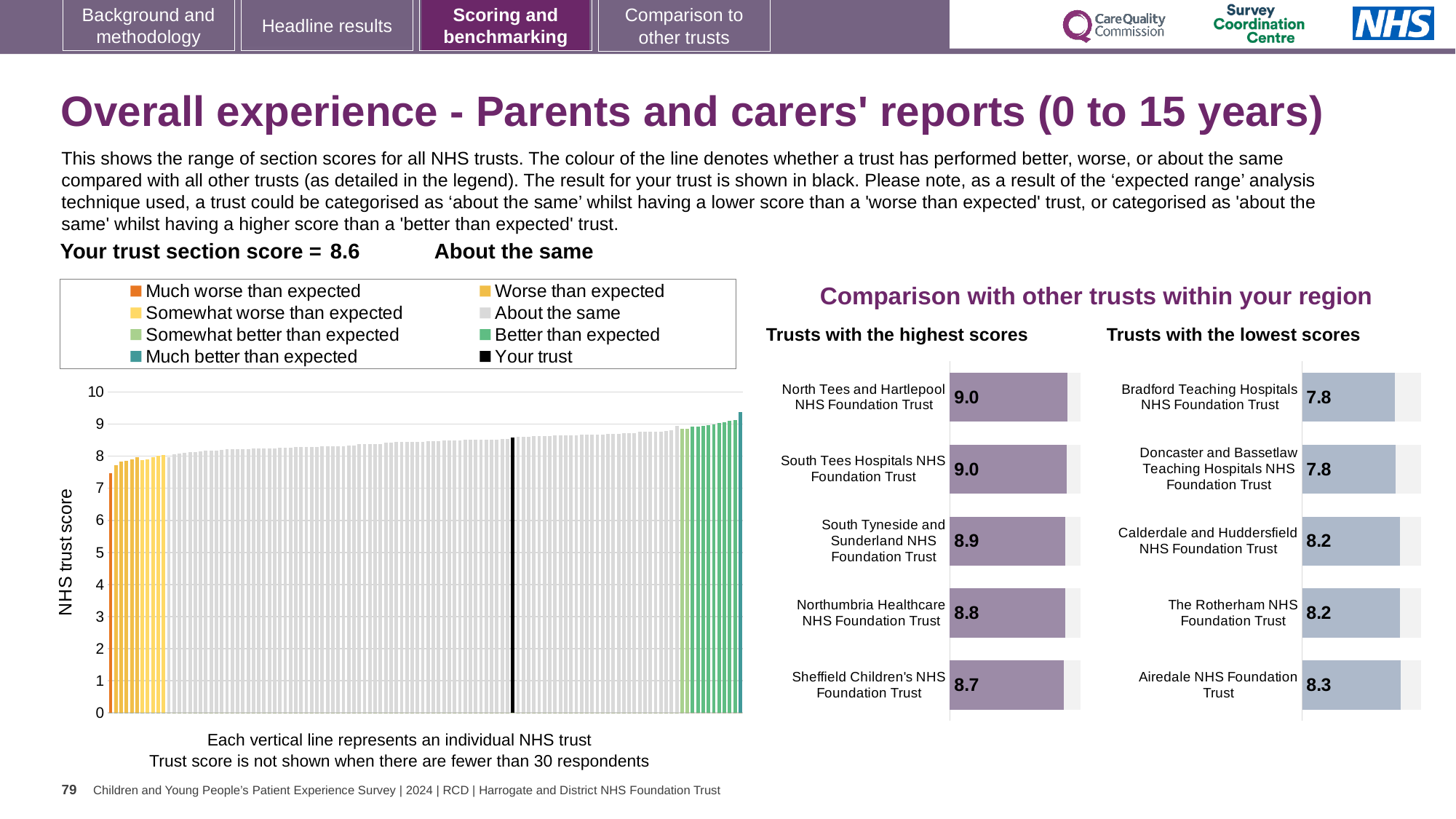
How many entries does the legend of the main NHS trust score chart list? 8 What kind of chart is the main chart showing NHS trust scores on the left of the slide? Bar chart How many trusts are shown in the 'Trusts with the highest scores' chart? 5 In the 'Trusts with the lowest scores' chart, which has the larger score: The Rotherham NHS Foundation Trust or Doncaster and Bassetlaw Teaching Hospitals NHS Foundation Trust? The Rotherham NHS Foundation Trust In the 'Trusts with the lowest scores' chart, what is the difference between the scores for Airedale NHS Foundation Trust and Bradford Teaching Hospitals NHS Foundation Trust? 0.5 In the 'Trusts with the lowest scores' chart, what is the score for Calderdale and Huddersfield NHS Foundation Trust? 8.2 In the 'Trusts with the highest scores' chart, what is the score for South Tyneside and Sunderland NHS Foundation Trust? 8.9 In the 'Trusts with the highest scores' chart, what is the score for Northumbria Healthcare NHS Foundation Trust? 8.8 In the 'Trusts with the highest scores' chart, which trust has the lowest score? Sheffield Children's NHS Foundation Trust In the main NHS trust score chart, do the bar values rise or fall from left to right along the x axis? Rise In the 'Trusts with the lowest scores' chart, which trust has the highest score? Airedale NHS Foundation Trust What is the difference between the score for Sheffield Children's NHS Foundation Trust in the 'highest scores' chart and the score for Airedale NHS Foundation Trust in the 'lowest scores' chart? 0.4